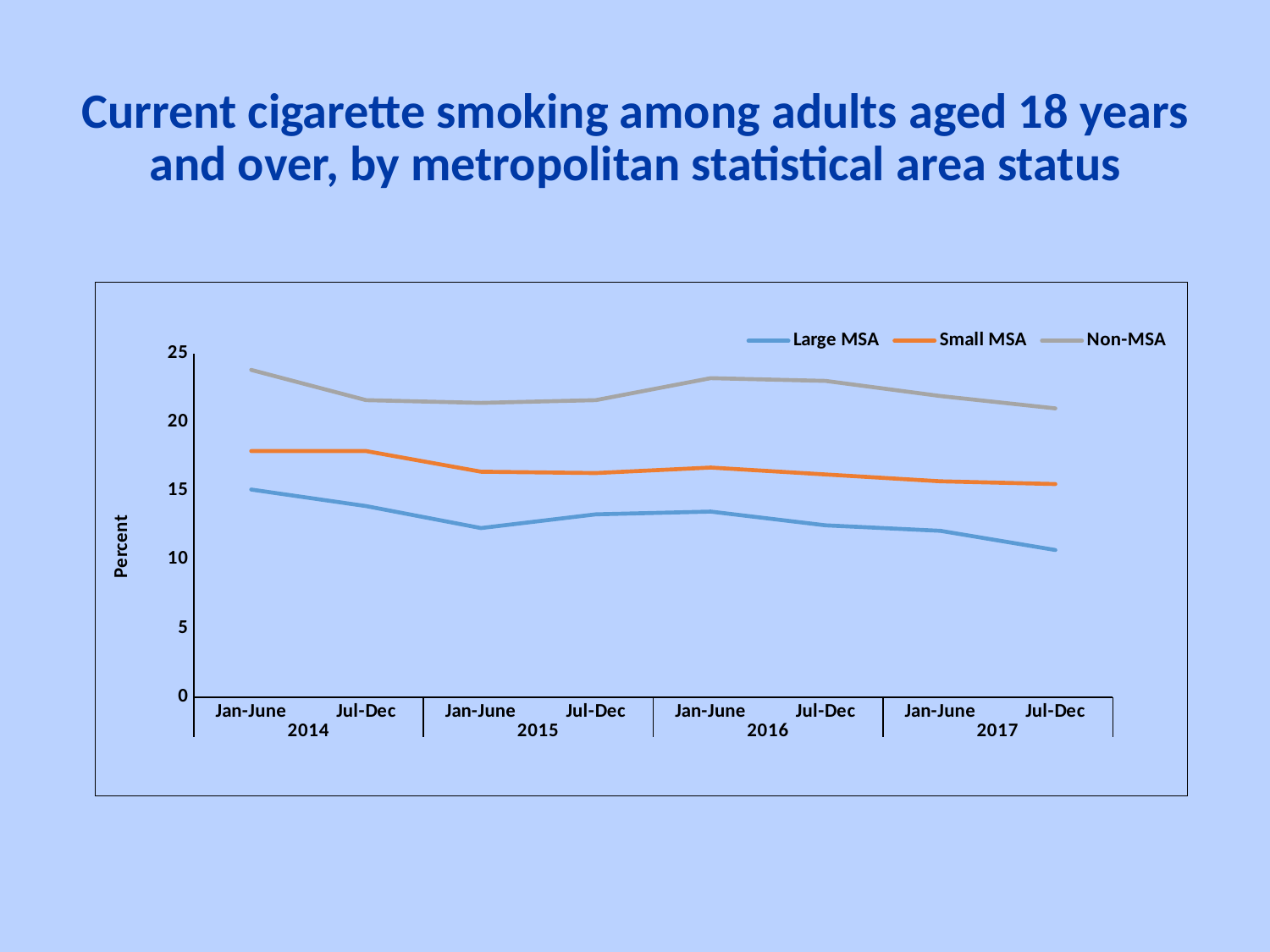
What kind of chart is shown on the slide? line chart How many series does the legend list? 3 Is the value for Non-MSA in Jan-June 2014 greater or less than 20? greater Which series has the highest values across the whole period? Non-MSA Is the value for Large MSA in Jan-June 2015 greater or less than 10? greater Does the Large MSA line rise or fall overall from Jan-June 2014 to Jul-Dec 2017? fall Is the value for Small MSA in Jan-June 2014 greater or less than 15? greater How many time points are plotted along the x axis? 8 Which is larger in Jul-Dec 2016: the value for Small MSA or the value for Large MSA? Small MSA What is the label on the vertical axis? Percent Which series has the lowest values across the whole period? Large MSA